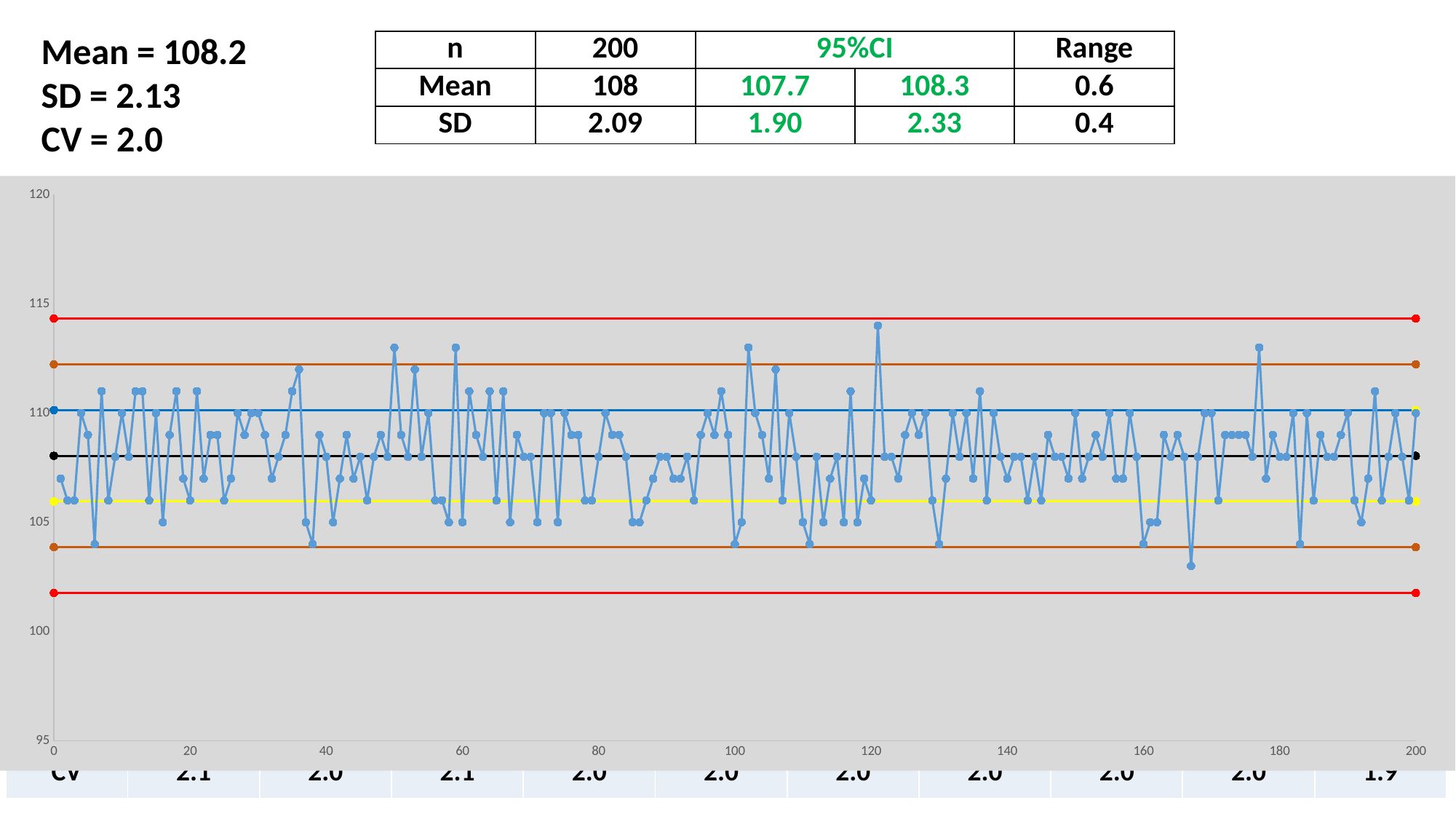
What kind of chart is shown on the slide? line chart What is the highest value shown on the vertical axis of the chart? 120 Is the highest plotted data point on the chart (near x = 121) greater or less than 110? greater What is the largest value labelled on the horizontal axis of the chart? 200 Is the lowest plotted data point on the chart above or below the lower orange horizontal line? below Is the highest plotted data point on the chart above or below the upper red horizontal line? below Is the lowest plotted data point on the chart (near x = 167) greater or less than 105? less Is the first plotted data point (at x = 0) greater or less than 110? less What colour is the horizontal reference line that sits at 110 on the chart? blue What is the lowest value shown on the vertical axis of the chart? 95 Do the plotted values show a steady rise, a steady fall, or fluctuation around a constant level along the x axis? fluctuation around a constant level